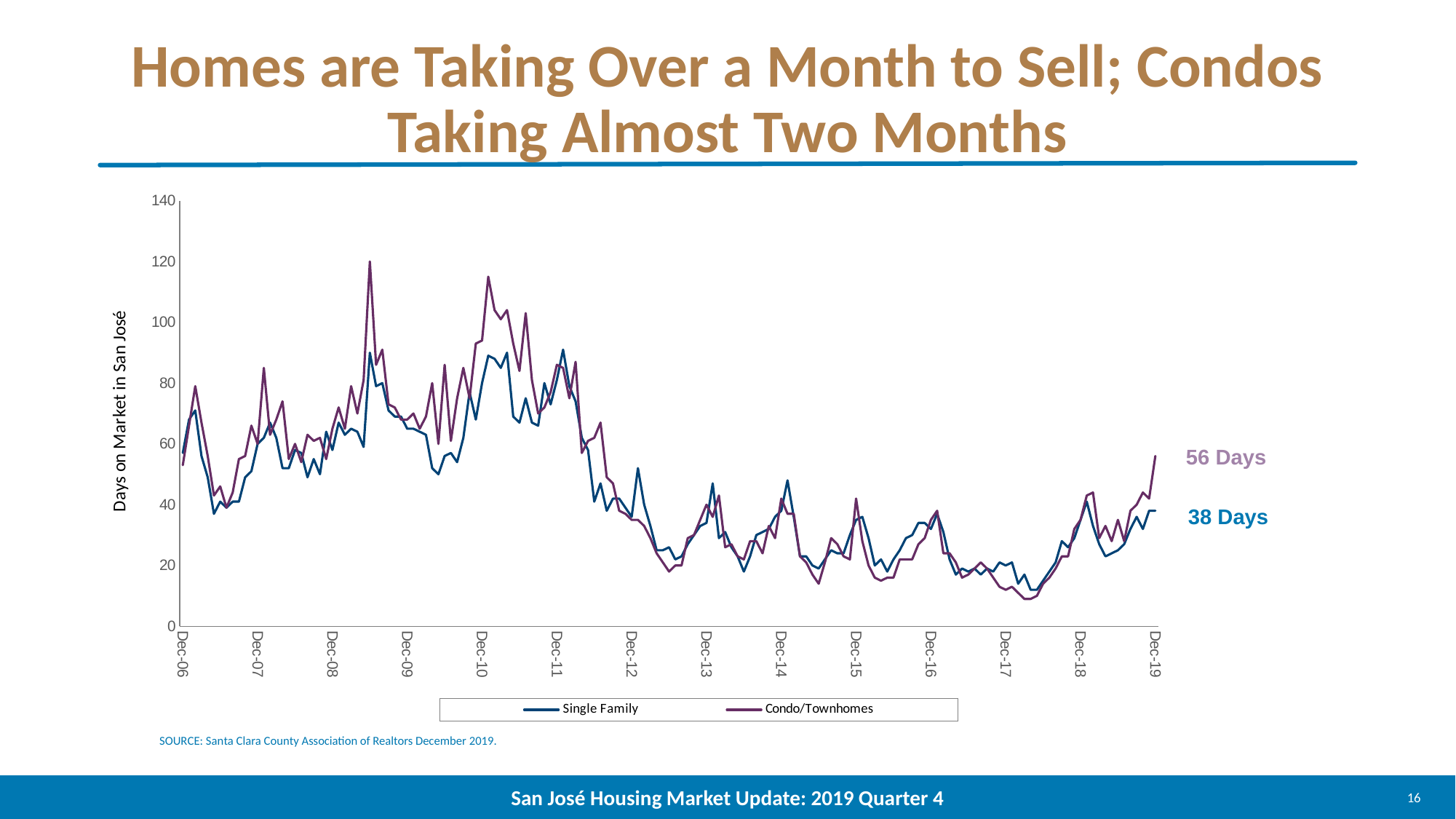
Is the highest value reached by the Condo/Townhomes line greater or less than 100? greater Is the Single Family value at Dec-19 greater or less than 40? less What kind of chart is shown on the slide? Line chart What is the title of the vertical axis? Days on Market in San José What is the Single Family value at Dec-19? 38 Days How many series does the legend list? 2 How many days more do Condo/Townhomes take than Single Family homes at Dec-19? 18 days Between Dec-11 and Dec-12, does the Single Family line generally rise or fall? fall How many year labels are shown on the x axis? 14 Which series reaches the higher peak over the whole period? Condo/Townhomes At Dec-19, which series has the higher days on market: Single Family or Condo/Townhomes? Condo/Townhomes What is the Condo/Townhomes value at Dec-19? 56 Days